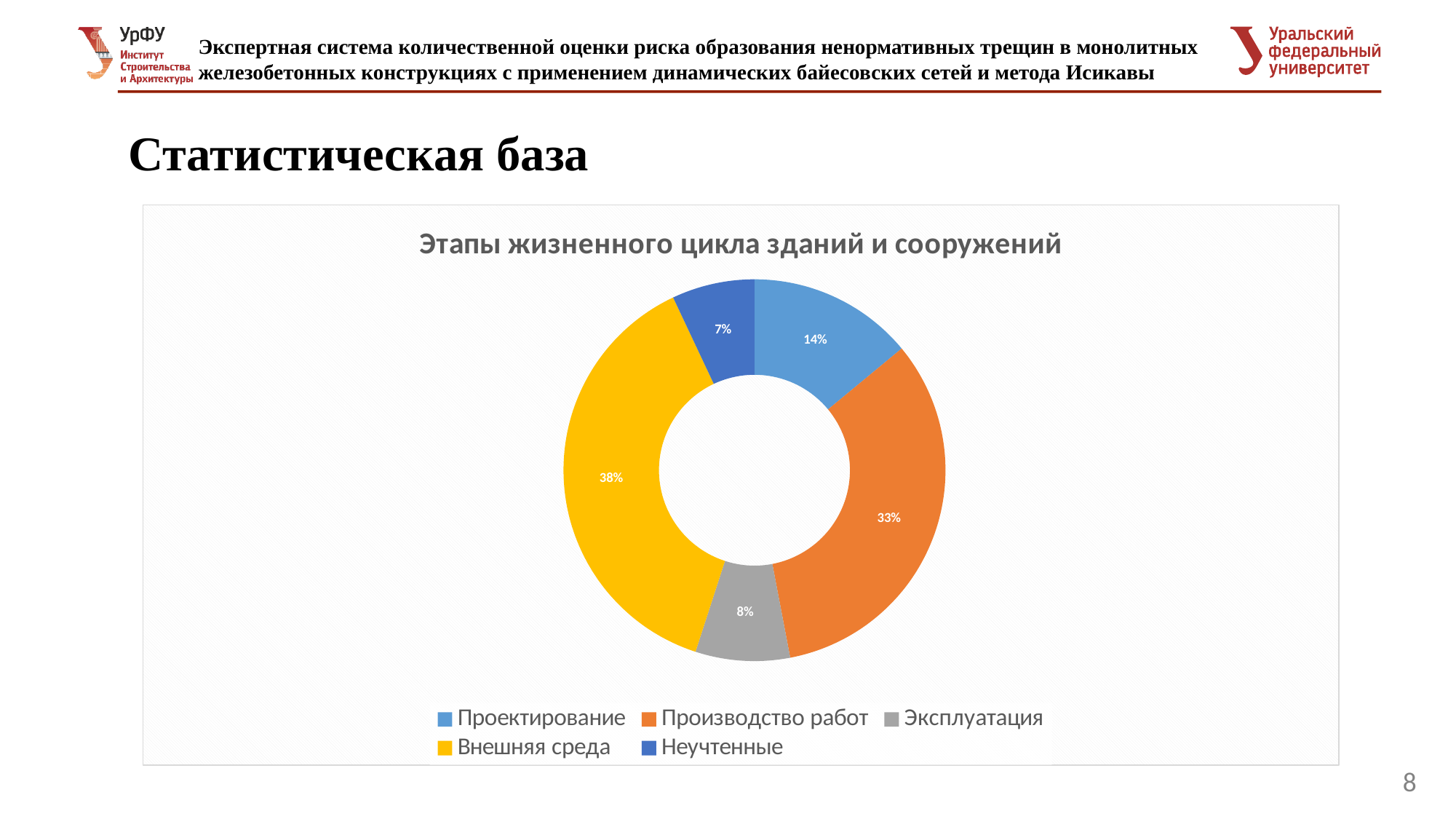
Which category has the smallest share? Неучтенные What colour is the Эксплуатация slice? Grey What is the value shown for Производство работ? 33% What share of the chart does Внешняя среда account for? 38% What is the value shown for Неучтенные? 7% How many categories does the chart show? 5 What kind of chart is shown on the slide? Doughnut (pie) chart What is the difference between the shares of Внешняя среда and Производство работ? 5% Which category has the largest share? Внешняя среда What is the title of the chart? Этапы жизненного цикла зданий и сооружений Which is larger, the share of Проектирование or the share of Эксплуатация? Проектирование What is the value shown for Проектирование? 14%